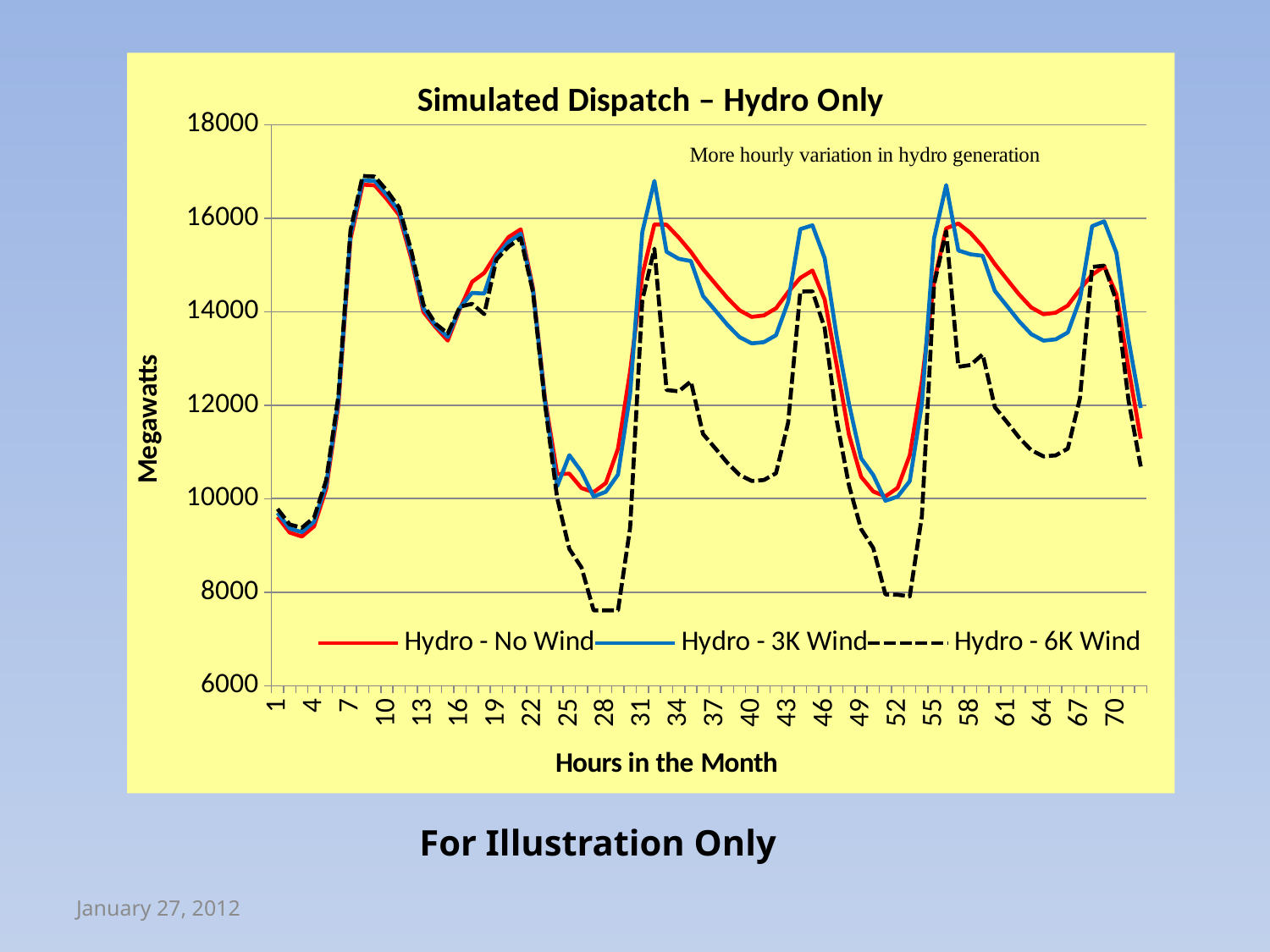
Between hour 1 and hour 8, do the values for Hydro - No Wind rise or fall? rise What is the title of the chart? Simulated Dispatch – Hydro Only How many series does the legend list? 3 Is the value for Hydro - 6K Wind at hour 28 greater or less than 8000? less Is the value for Hydro - 3K Wind at hour 40 greater or less than 14000? less At hour 28, which series has the higher value, Hydro - No Wind or Hydro - 6K Wind? Hydro - No Wind At hour 64, which series has the higher value, Hydro - No Wind or Hydro - 6K Wind? Hydro - No Wind What kind of chart is shown on the slide? Line chart Is the value for Hydro - 6K Wind at hour 40 greater or less than 10000? greater What is the label on the vertical axis? Megawatts Which series reaches the lowest value anywhere on the chart? Hydro - 6K Wind